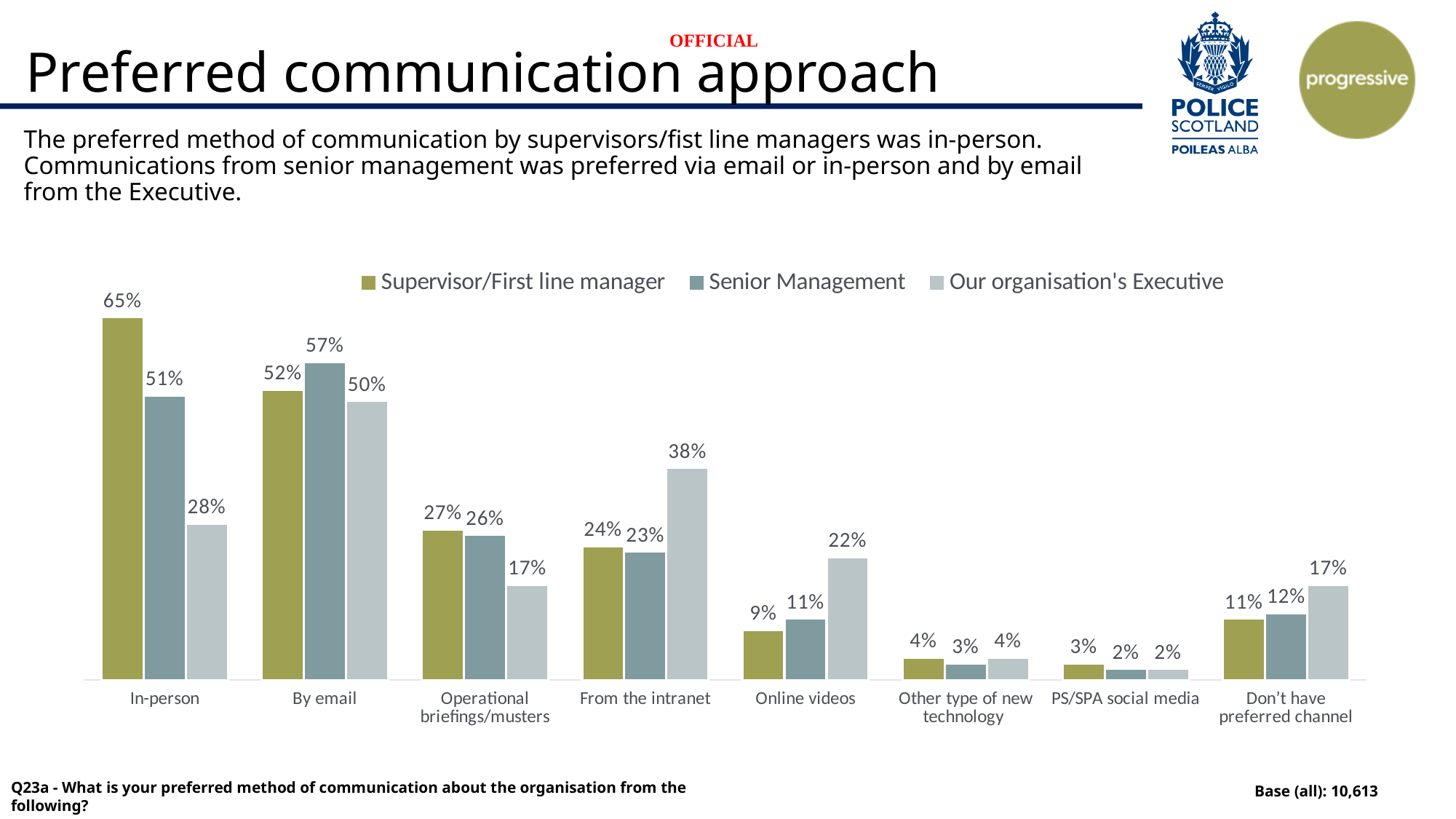
Which category has the highest value for Our organisation's Executive? By email What is the difference between the Supervisor/First line manager and Our organisation's Executive values for In-person? 37% What is the value for 'From the intranet' for Our organisation's Executive? 38% What is the Senior Management value for 'By email'? 57% What percentage of respondents preferred in-person communication from their Supervisor/First line manager? 65% Which series is shown in the olive/gold colour in the legend? Supervisor/First line manager What kind of chart is shown on the slide? Bar chart For 'Online videos', which series has the larger value: Senior Management or Our organisation's Executive? Our organisation's Executive How many communication method categories are shown on the x axis? 8 Which category has the lowest value for Supervisor/First line manager? PS/SPA social media How many series does the legend list? 3 What is the difference between the Our organisation's Executive and Senior Management values for 'From the intranet'? 15%